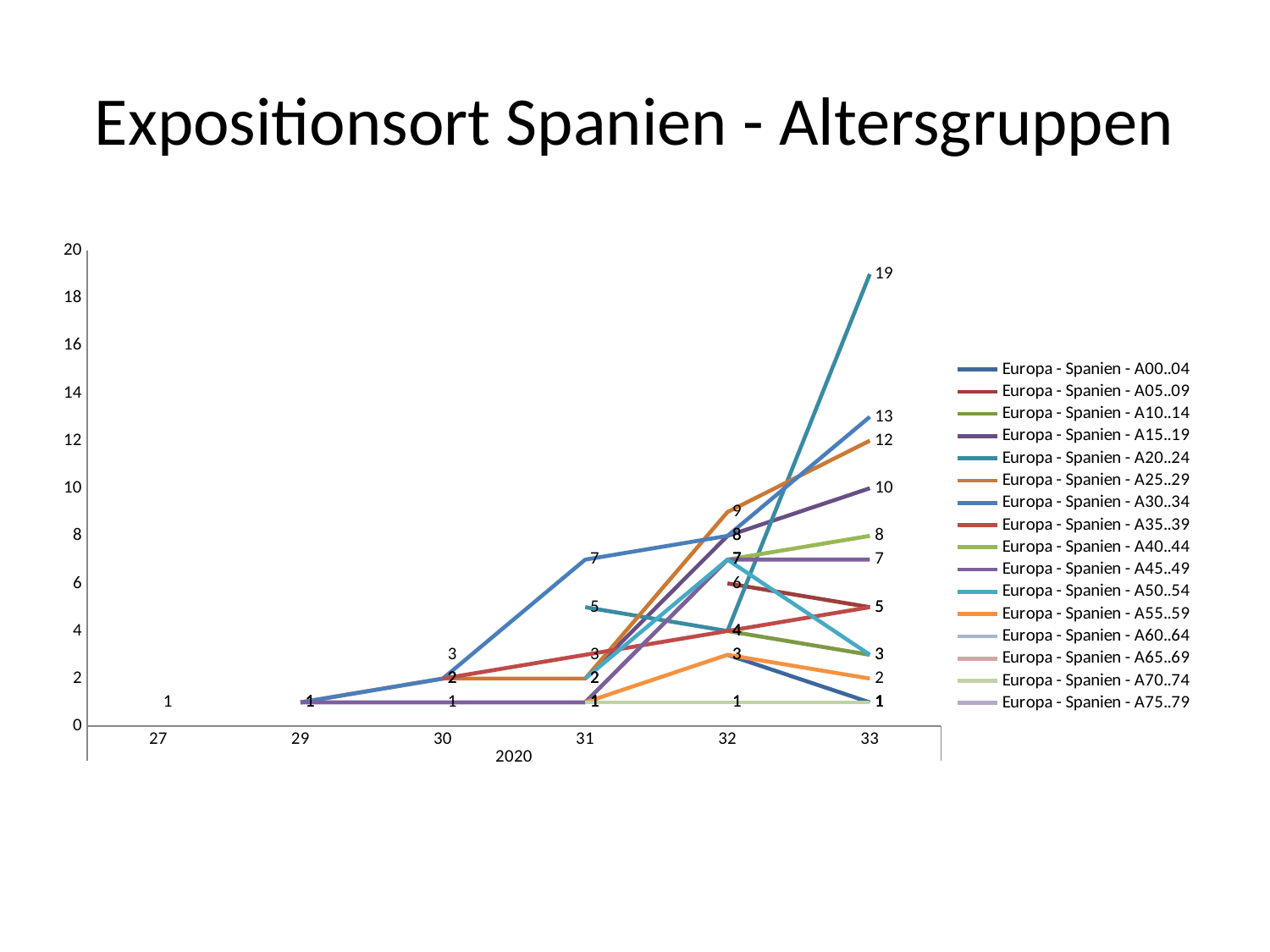
What is the highest value plotted at week 33? 19 What is the highest value plotted anywhere on the chart? 19 What is the value for Europa - Spanien - A30..34 at week 31? 7 What is the title of the chart? Expositionsort Spanien - Altersgruppen How many categories are shown on the x axis? 6 How many series does the legend list? 16 What is the difference between the highest value at week 33 (19) and the value for Europa - Spanien - A30..34 at week 33? 6 What is the value for Europa - Spanien - A30..34 at week 33? 13 Does the value for Europa - Spanien - A30..34 rise or fall from week 29 to week 33? rise What is the value for Europa - Spanien - A25..29 at week 33? 12 What kind of chart is shown on the slide? line chart Is the highest value at week 33 greater or less than 18? greater